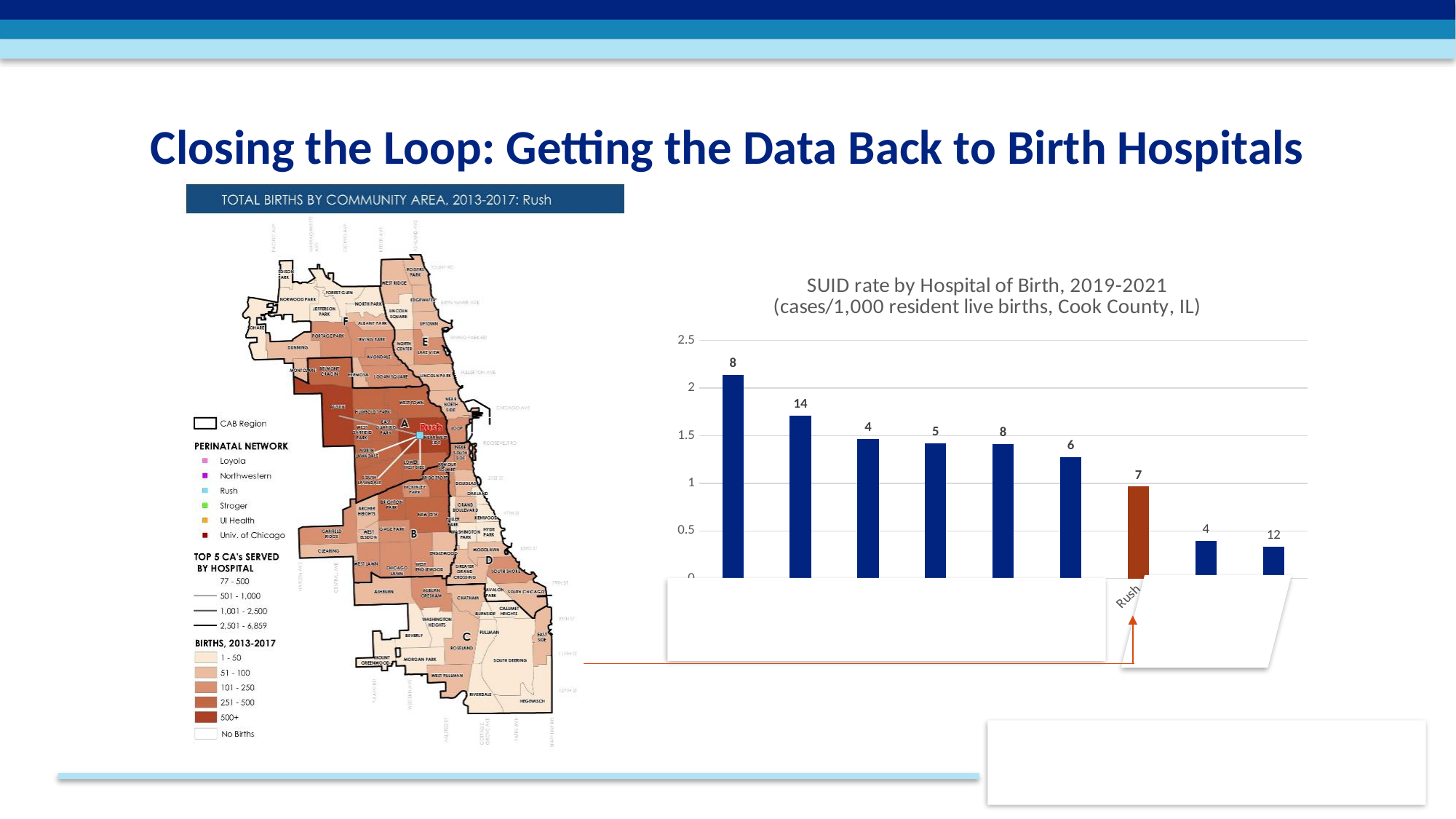
In the 'SUID rate by Hospital of Birth' chart, what number is printed above the Rush bar? 7 What is the highest value shown on the vertical axis of the 'SUID rate by Hospital of Birth' chart? 2.5 In the 'SUID rate by Hospital of Birth' chart, do the bar heights generally rise or fall from left to right? fall How many bars are plotted in the 'SUID rate by Hospital of Birth, 2019-2021' chart? 9 In the 'SUID rate by Hospital of Birth' chart, is the bar for Rush greater or less than 1.5? less What kind of chart is the 'SUID rate by Hospital of Birth, 2019-2021' chart? bar chart In the 'SUID rate by Hospital of Birth' chart, is the leftmost bar greater or less than 2? greater In the 'SUID rate by Hospital of Birth' chart, is the bar for Rush greater or less than 0.5? greater In the 'SUID rate by Hospital of Birth' chart, which hospital's bar is coloured orange instead of blue? Rush In the 'SUID rate by Hospital of Birth' chart, is the Rush bar taller or shorter than the leftmost bar? shorter